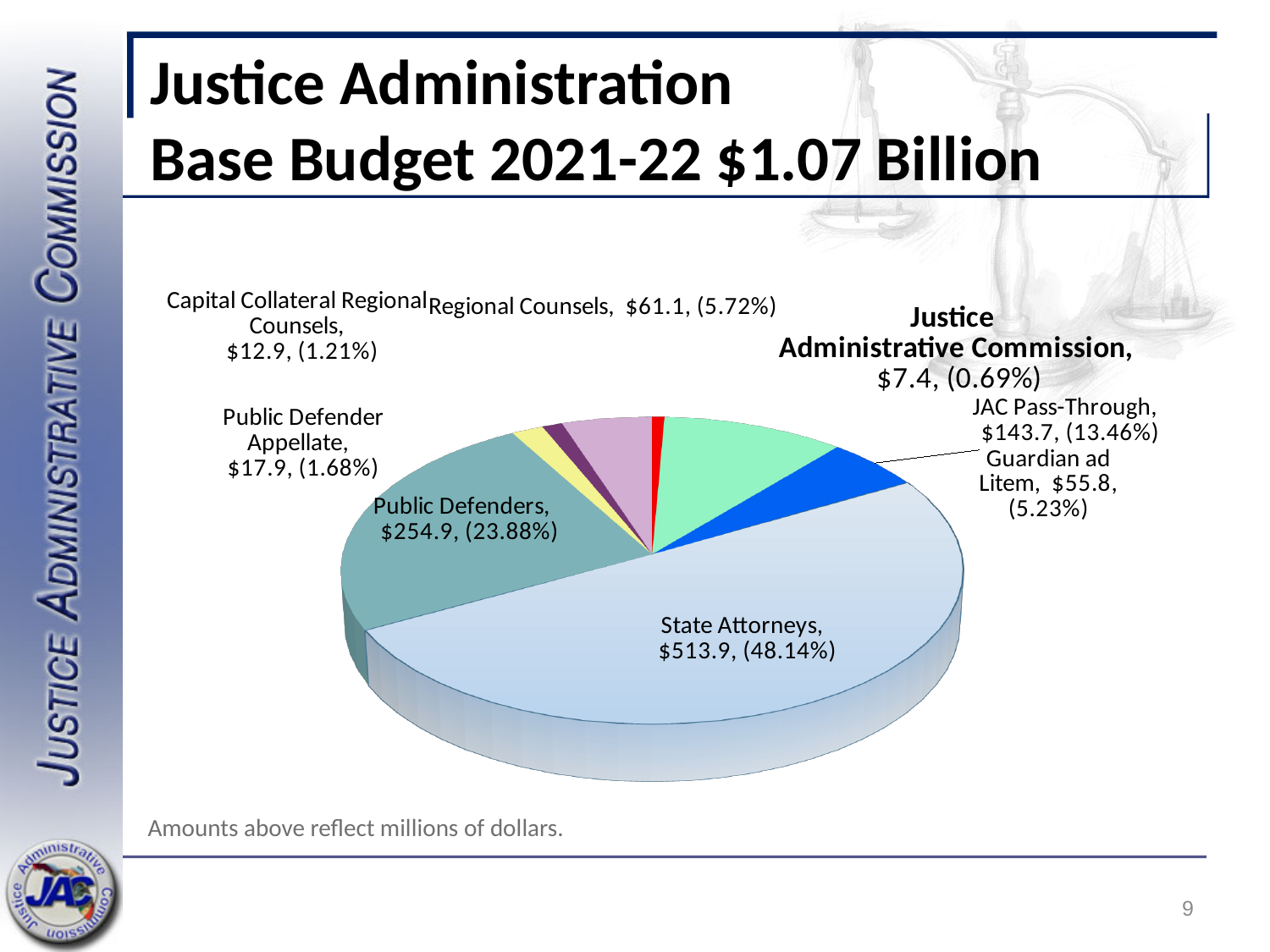
How many slices does the pie chart have? 8 What is the amount shown for State Attorneys? $513.9 Which category has the largest slice of the pie? State Attorneys What is the amount shown for Public Defenders? $254.9 What kind of chart is shown on the slide? Pie chart What share of the pie does Regional Counsels represent? 5.72% What share of the pie does Guardian ad Litem represent? 5.23% What is the difference in amount between State Attorneys and Public Defenders? $259.0 Which is larger, the amount for Public Defender Appellate or the amount for Capital Collateral Regional Counsels? Public Defender Appellate What is the amount shown for JAC Pass-Through? $143.7 According to the slide title, what is the total Justice Administration base budget for 2021-22? $1.07 Billion Which category has the smallest slice of the pie? Justice Administrative Commission